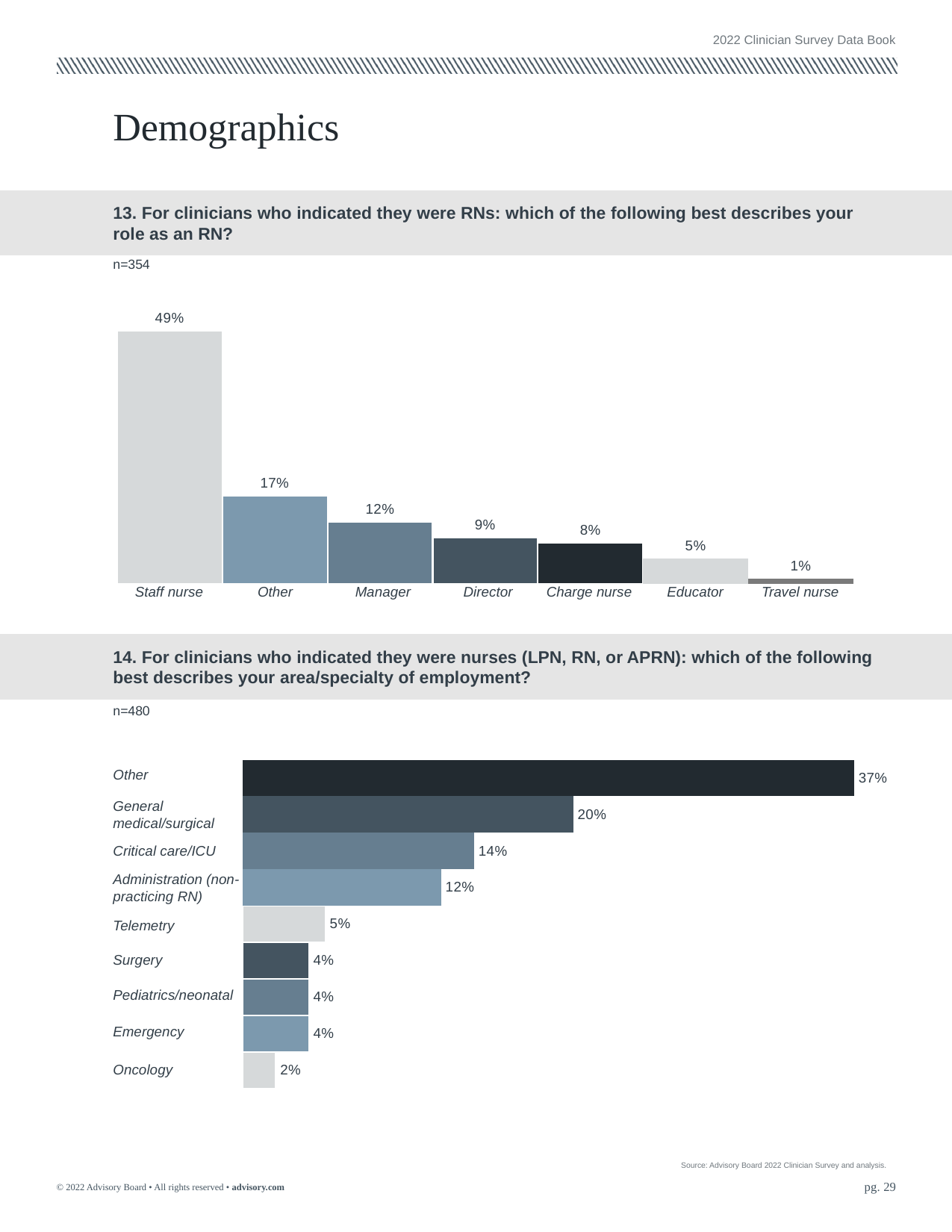
What is the sample size (n) shown for the question 13 chart? n=354 In the chart for question 14 (area/specialty of employment), how many categories are shown? 9 What type of chart is used for question 14 (area/specialty of employment)? Bar chart In the chart for question 13 (RN role), which role has the lowest percentage? Travel nurse In the chart for question 13 (RN role), how many role categories are shown? 7 In the chart for question 14 (area/specialty of employment), what is the difference between Other and General medical/surgical? 17% In the chart for question 14 (area/specialty of employment), which category has the highest percentage? Other In the chart for question 13 (RN role), what is the value for Educator? 5% In the chart for question 13 (RN role), which is larger, Director or Charge nurse? Director In the chart for question 14 (area/specialty of employment), what percentage is Critical care/ICU? 14% In the chart for question 13 (RN role), what percentage of respondents are staff nurses? 49% In the chart for question 13 (RN role), what is the difference between the Other and Manager percentages? 5%